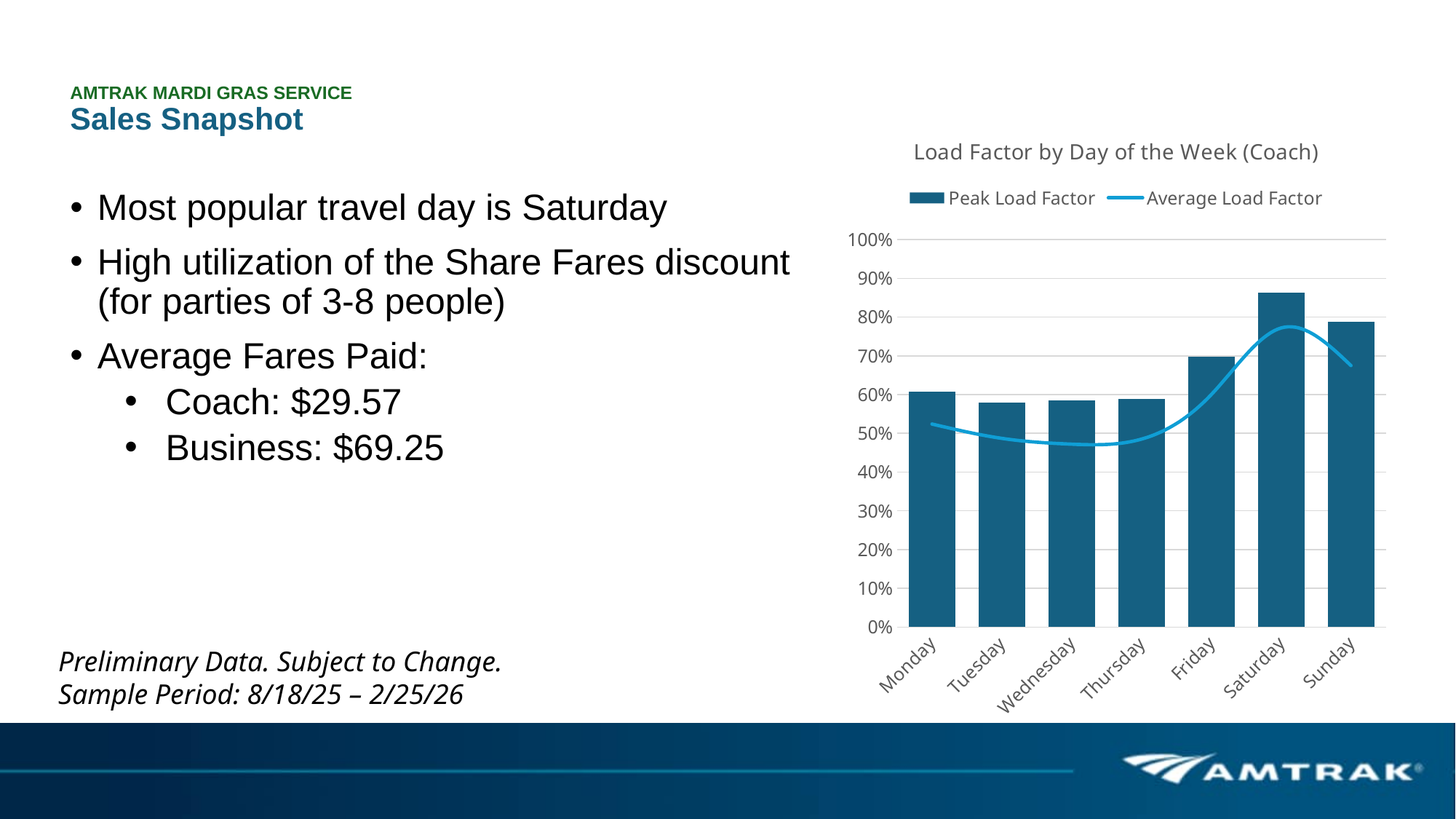
Which day has the highest Average Load Factor? Saturday Is the Peak Load Factor for Sunday greater or less than 70%? greater Which series is shown as a line in the chart? Average Load Factor Is the Peak Load Factor for Tuesday greater or less than 60%? less How many series does the chart's legend list? 2 Does the Peak Load Factor rise or fall from Thursday to Saturday? rise What is the title of the chart? Load Factor by Day of the Week (Coach) Is the Peak Load Factor for Saturday greater or less than 80%? greater Which day has the highest Peak Load Factor? Saturday How many days of the week are shown on the x axis of the chart? 7 Which has the larger Peak Load Factor, Saturday or Sunday? Saturday